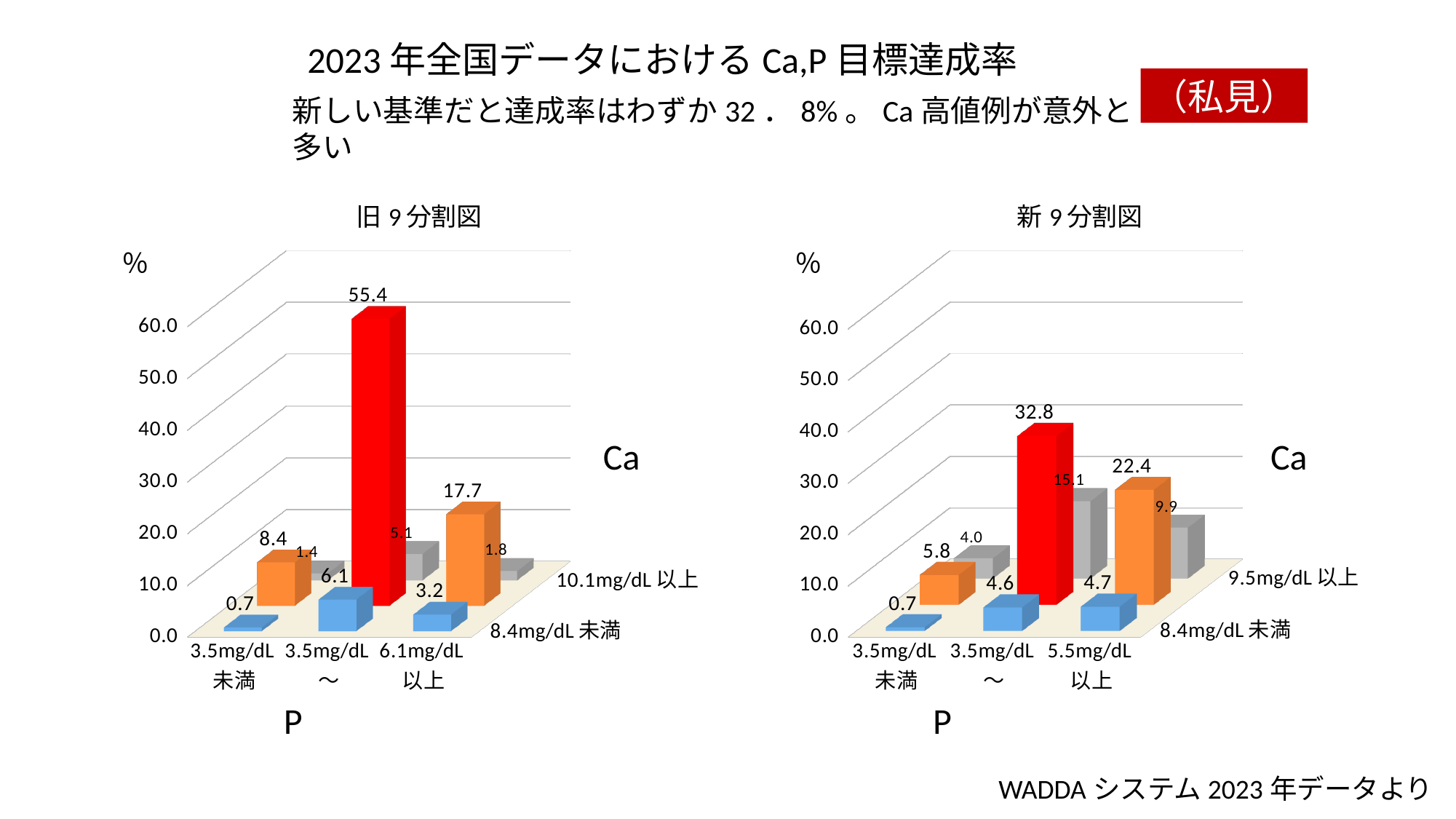
What is the title of the left chart? 旧9分割図 In the right chart (新9分割図), what is the value of the tallest (red) bar? 32.8 In the left chart (旧9分割図), what is the value of the gray bar for P 6.1mg/dL以上 in the Ca 10.1mg/dL以上 row? 1.8 In the left chart (旧9分割図), what is the difference between the blue bars for P 3.5mg/dL～ (6.1) and P 6.1mg/dL以上 (3.2)? 2.9 What type of chart is used on this slide? Bar chart In the left chart (旧9分割図), is the value of the red bar greater or less than 50? greater In the right chart (新9分割図), which is larger: the gray bar for P 3.5mg/dL～ or the gray bar for P 5.5mg/dL以上? The gray bar for P 3.5mg/dL～ (15.1) How many bars are plotted in the left chart (旧9分割図)? 9 In the left chart (旧9分割図), what is the highest value shown on any bar? 55.4 What is the difference between the tallest red bar in the left chart (55.4) and the tallest red bar in the right chart (32.8)? 22.6 In the left chart (旧9分割図), what is the value of the blue bar for P 3.5mg/dL未満 in the Ca 8.4mg/dL未満 row? 0.7 In the right chart (新9分割図), what is the value of the gray bar for P 3.5mg/dL～ in the Ca 9.5mg/dL以上 row? 15.1